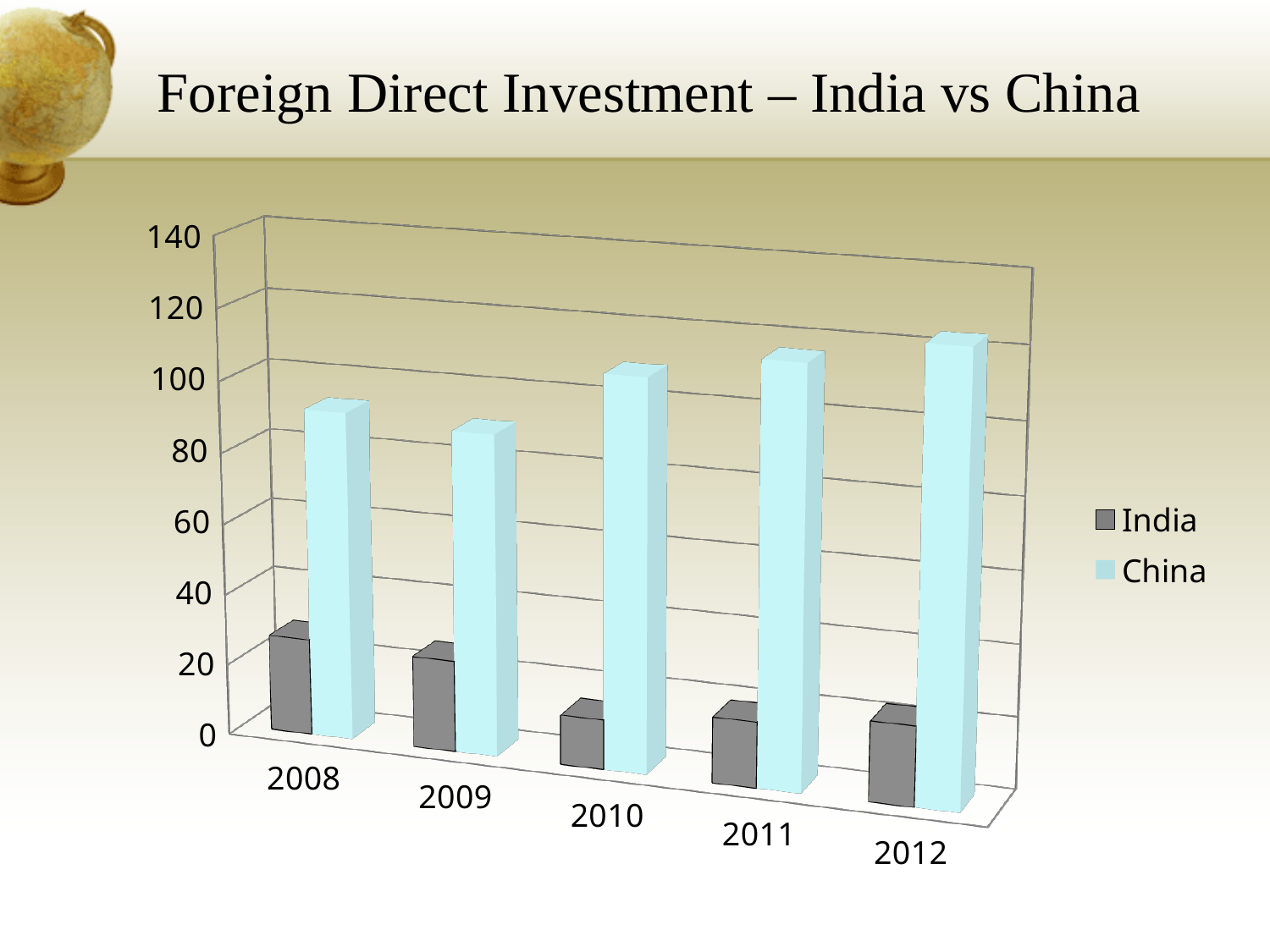
How many years are shown on the x axis of the chart? 5 In which year is the India bar the highest? 2008 Is the value for India in 2010 greater or less than 20? less Is the value for China in 2012 greater or less than 100? greater What kind of chart is shown on the slide? bar chart How many series does the chart's legend list? 2 In 2010, which is larger, the value for India or the value for China? China In which year is the China bar the lowest? 2009 Which series does the legend list first? India Is the value for China in 2008 greater or less than 60? greater What is the title of the slide containing the chart? Foreign Direct Investment – India vs China